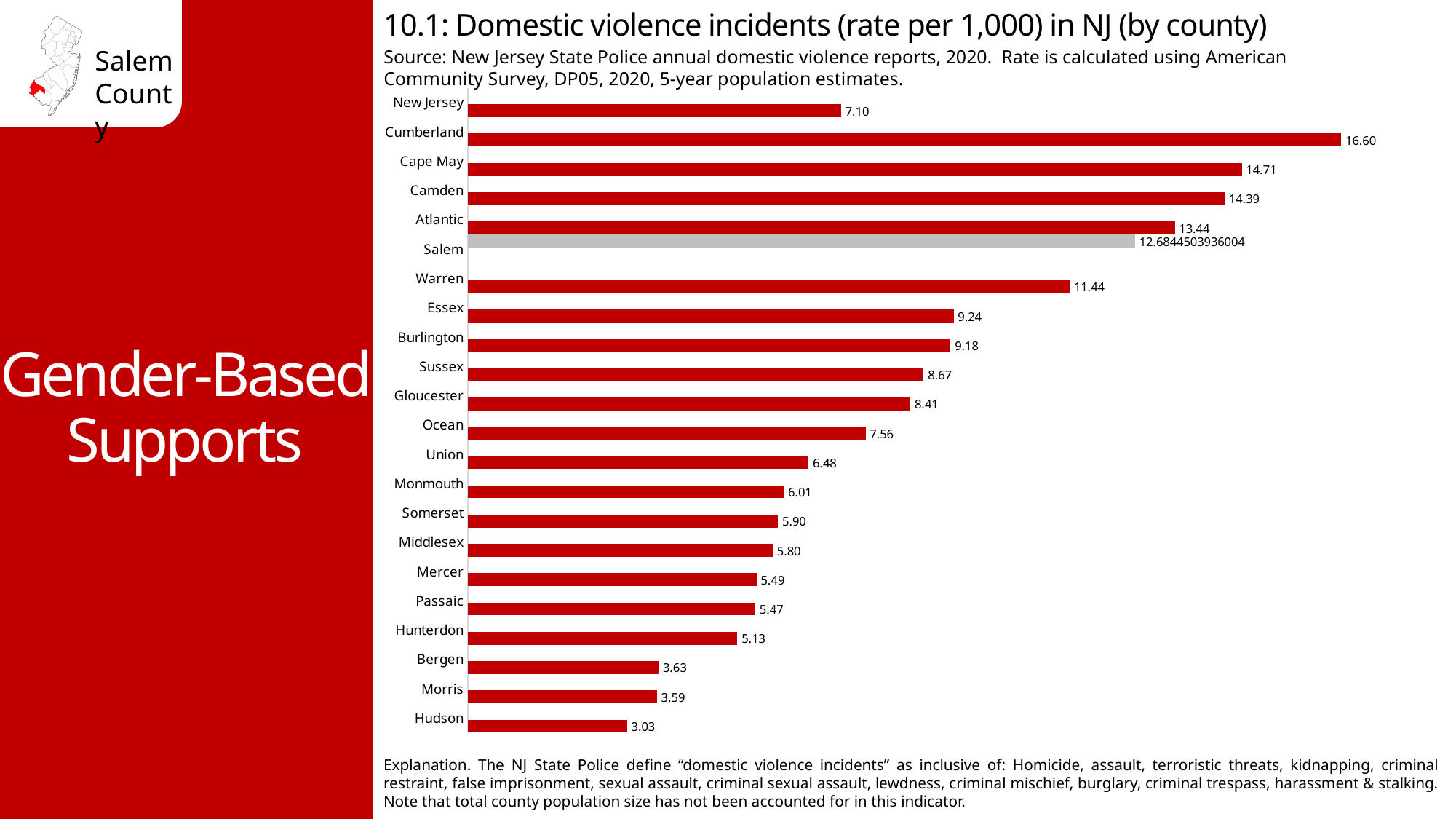
Which has a higher rate, Cape May or Camden? Cape May What is the rate shown for New Jersey as a whole? 7.10 What is the rate for Warren? 11.44 How many bars are shown in the chart? 22 Which county has the lowest domestic violence incident rate? Hudson Which has a higher rate, Bergen or Morris? Bergen What is the difference between the rates for Cumberland and Hudson? 13.57 What is the domestic violence incident rate for Cumberland? 16.60 Which county has the highest domestic violence incident rate? Cumberland What is the difference between the rates for Essex and Burlington? 0.06 What type of chart is used on this slide? Bar chart What value is printed for Salem? 12.6844503936004